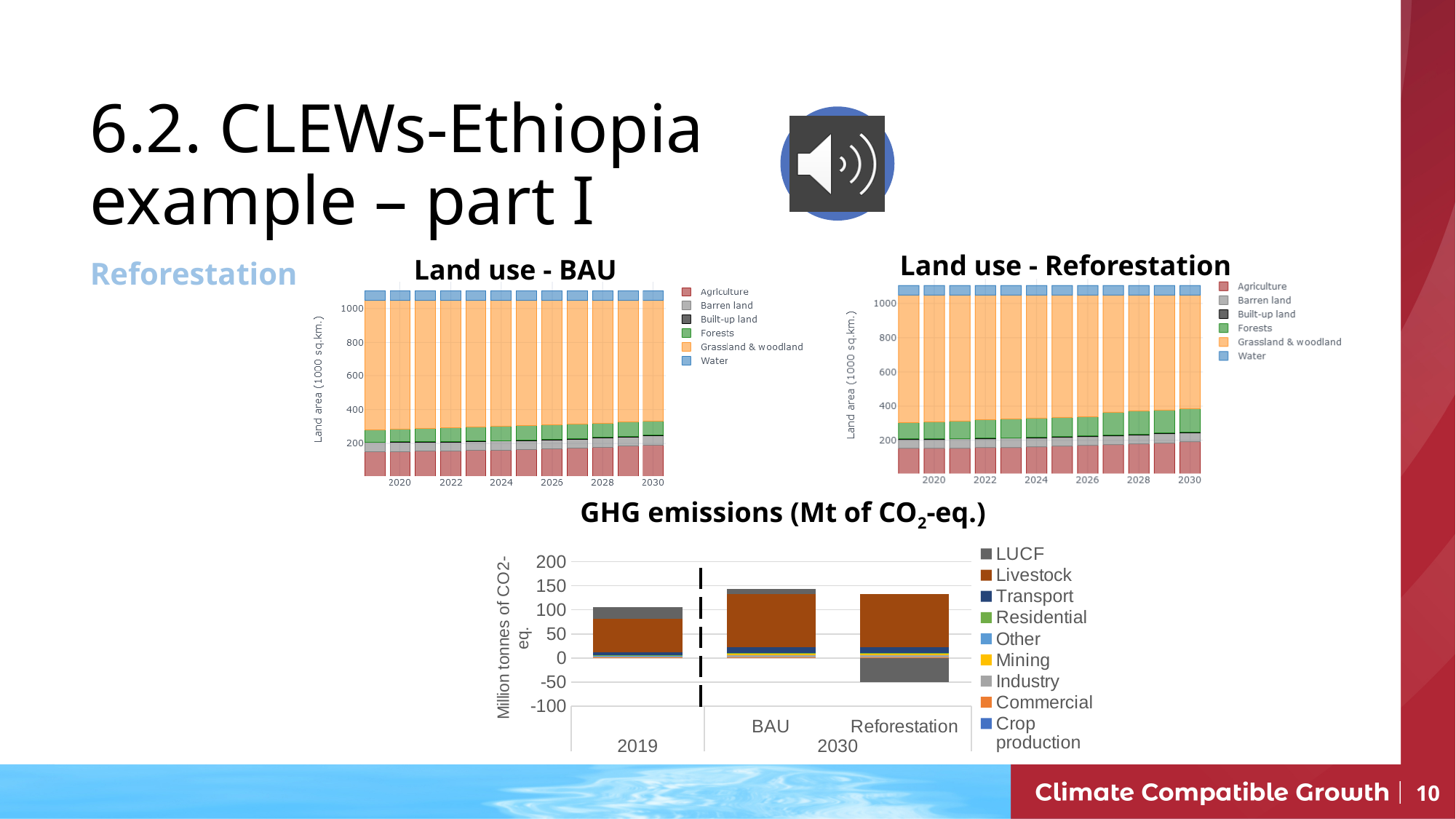
What kind of chart is the 'GHG emissions (Mt of CO2-eq.)' chart? Stacked bar chart In the 'GHG emissions (Mt of CO2-eq.)' chart, which bar reaches higher: 2019 or 2030 BAU? 2030 BAU How many series does the legend of the 'GHG emissions (Mt of CO2-eq.)' chart list? 9 How many years (bars) are plotted in the 'Land use - Reforestation' chart? 11 In the 'GHG emissions (Mt of CO2-eq.)' chart, is the top of the 2030 BAU bar greater or less than 100? greater How many series does the legend of the 'Land use - BAU' chart list? 6 In the 'Land use - Reforestation' chart, does the Forests area rise or fall from 2020 to 2030? rise In the 'GHG emissions (Mt of CO2-eq.)' chart, which series makes up the largest part of each bar? Livestock What is the y-axis label of the 'Land use - BAU' chart? Land area (1000 sq.km.) In the 'GHG emissions (Mt of CO2-eq.)' chart, is the LUCF value for the 2030 Reforestation bar greater or less than 0? less In the 'Land use - BAU' chart, is the total land area of each stacked bar greater or less than 1000? greater How many bars are plotted in the 'GHG emissions (Mt of CO2-eq.)' chart? 3